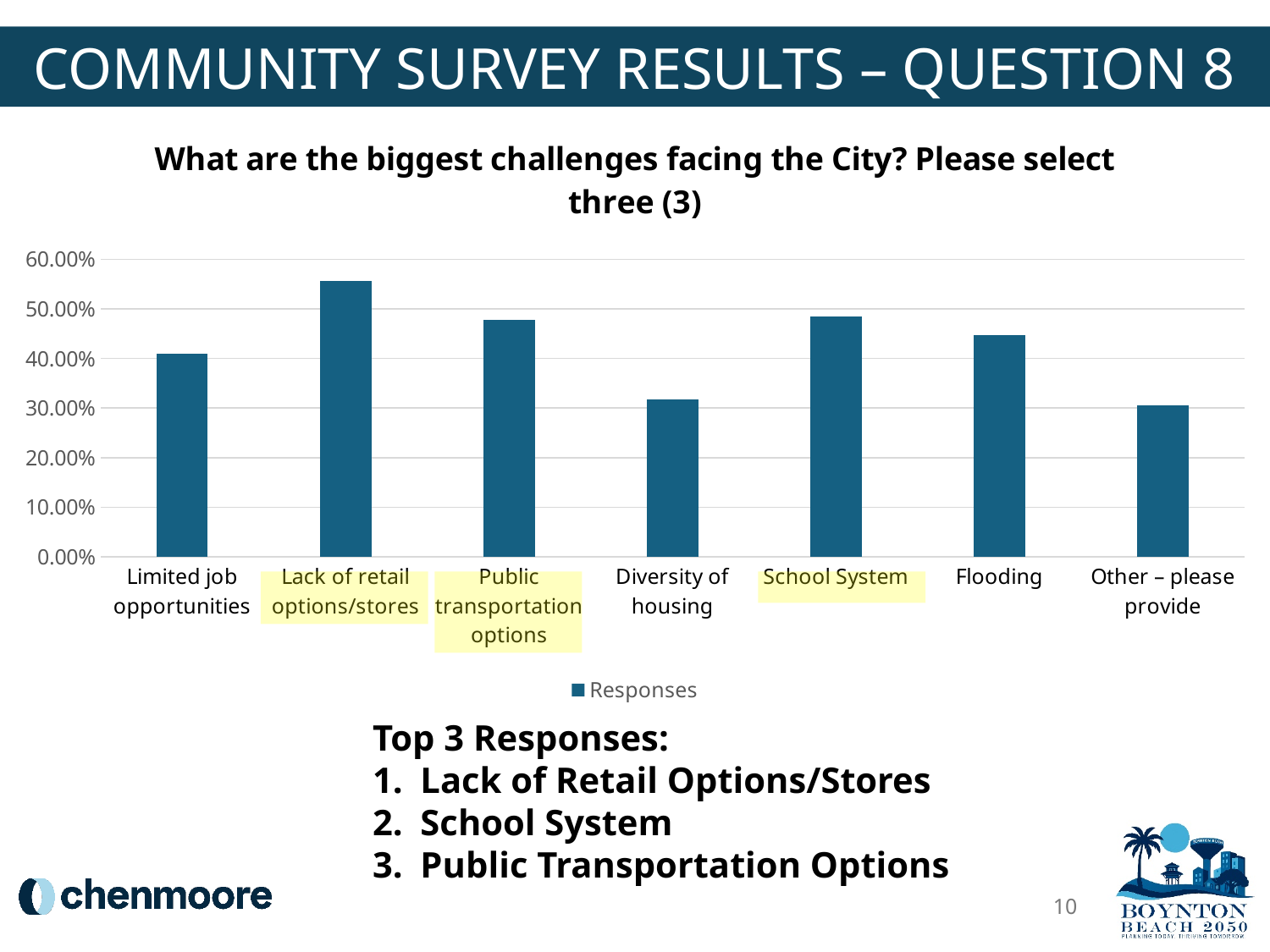
Which is larger, the value for Flooding or the value for Diversity of housing? Flooding Is the value for Public transportation options greater or less than 40.00%? greater How many series does the chart's legend list? 1 What kind of chart is shown on the slide? bar chart Which is larger, the value for Lack of retail options/stores or the value for School System? Lack of retail options/stores Is the value for Flooding greater or less than 50.00%? less How many categories are shown on the x axis of the chart? 7 Is the value for Diversity of housing greater or less than 40.00%? less What is the name of the series shown in the chart's legend? Responses Which category has the highest value in the chart? Lack of retail options/stores